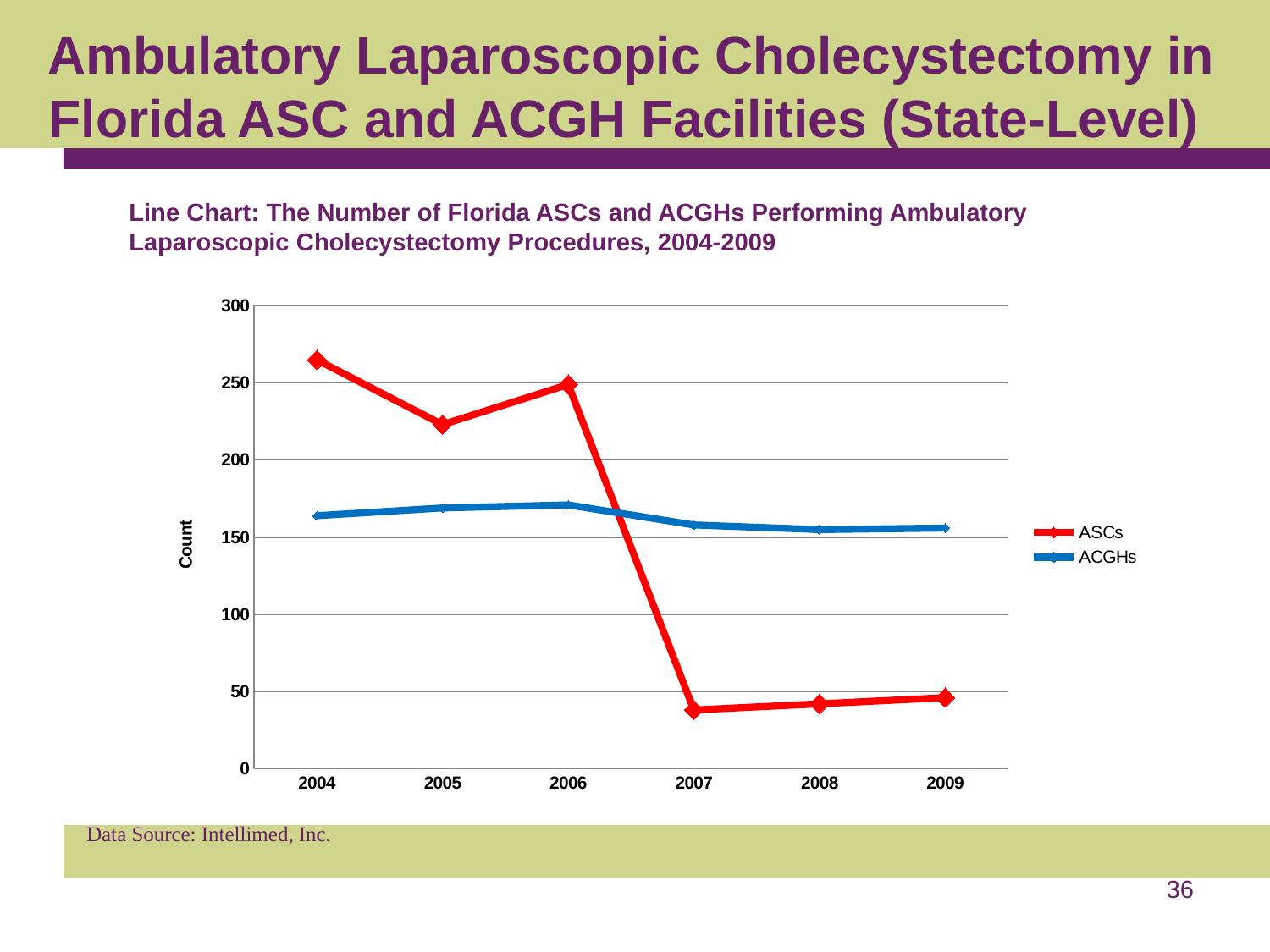
In which year is the ASCs series at its lowest? 2007 How many years are plotted along the x axis? 6 In which year is the ASCs series at its highest? 2004 Is the value for ASCs in 2004 greater or less than 250? greater Is the value for ACGHs in 2006 greater or less than 150? greater What is the label on the y axis? Count Which series has the larger value in 2005, ASCs or ACGHs? ASCs Is the value for ACGHs in 2009 greater or less than 200? less Which series has the larger value in 2008, ASCs or ACGHs? ACGHs What kind of chart is shown on the slide? Line chart How many series does the legend list? 2